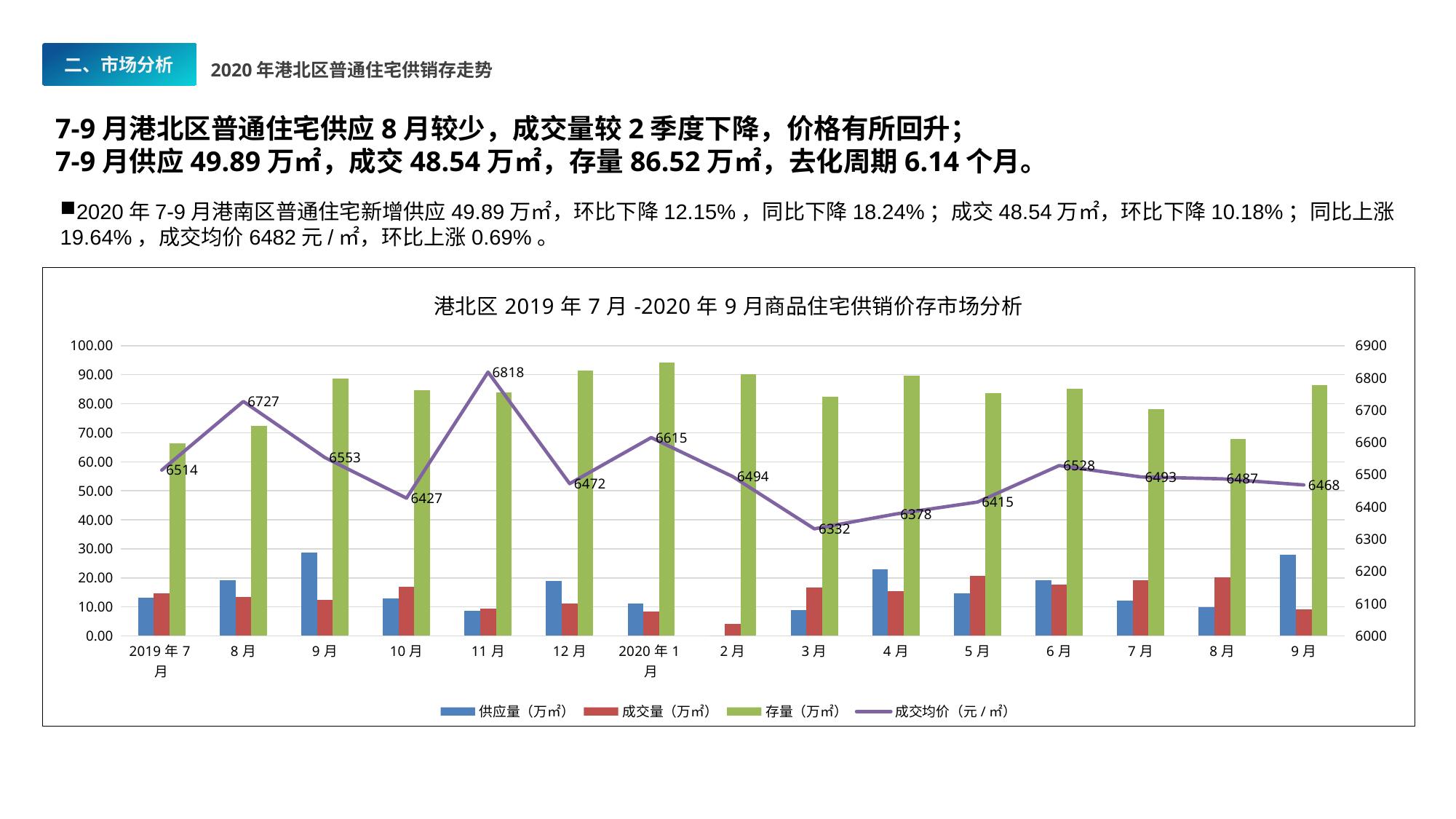
Is the 存量 value for 2020年1月 greater or less than 90.00? greater Is the 成交量 value for 2月 (2020) greater or less than 10.00? less What is the 成交均价 value for 2020年1月? 6615 What is the difference between the highest 成交均价 (11月 2019) and the lowest (3月 2020)? 486 Which month has the lowest 成交均价? 3月 (2020) How many series does the legend list? 4 Which month has the highest 成交均价? 11月 (2019) How many months are shown on the x axis? 15 Which is larger, the 成交均价 for 8月 2019 or for 8月 2020? 8月 2019 Does the 成交均价 line rise or fall from 6月 2020 to 9月 2020? fall What is the 成交均价 value for 9月 (2020)? 6468 What is the 成交均价 value for 11月 (2019)? 6818